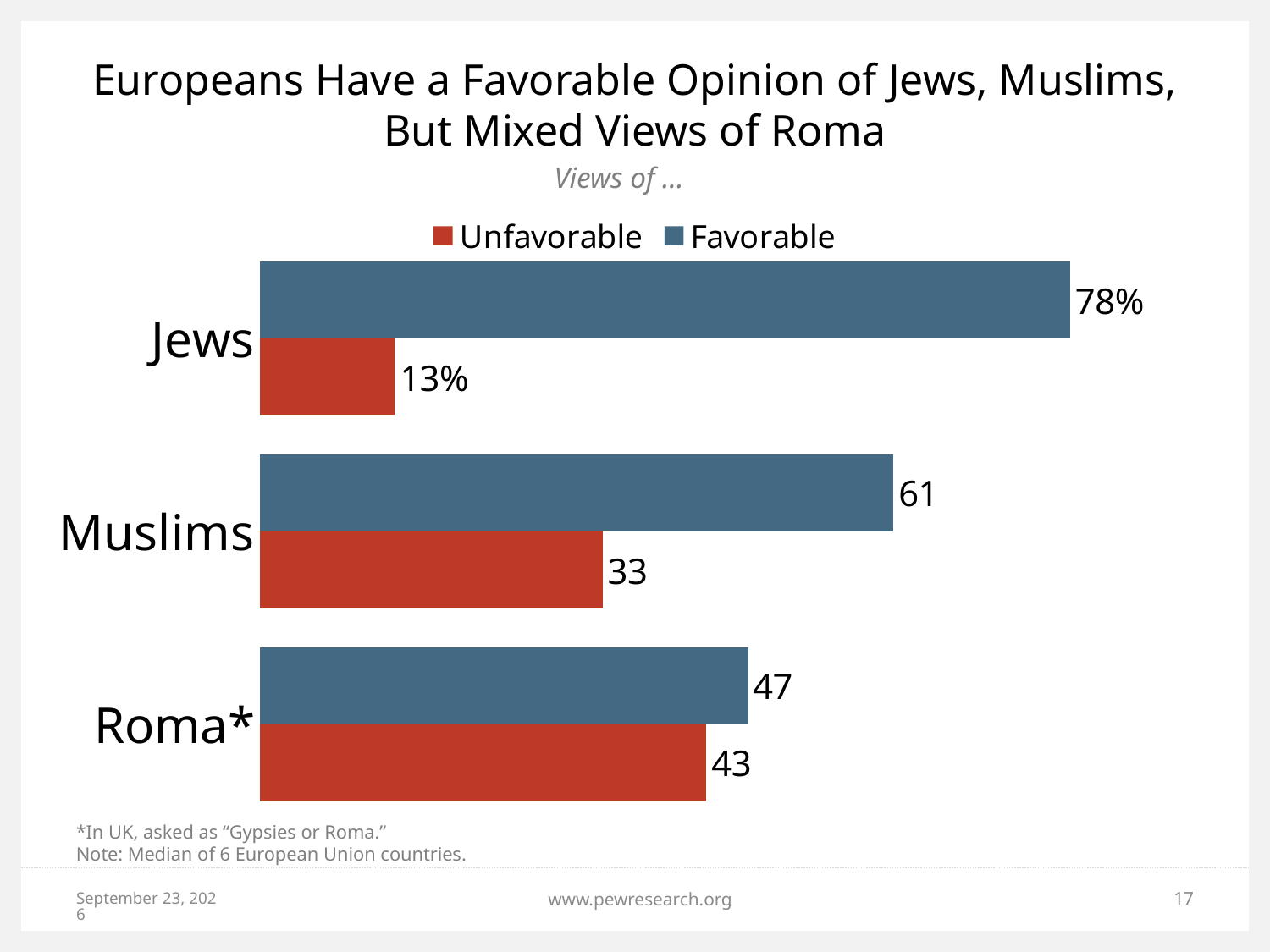
What is the Favorable value for Jews? 78% What is the Favorable value for Roma*? 47 What kind of chart is shown on the slide? Bar chart What is the Unfavorable value for Jews? 13% What is the difference between the Favorable and Unfavorable values for Muslims? 28 What is the Unfavorable value for Muslims? 33 How many series does the legend list? 2 Which is larger for Roma*, the Favorable or the Unfavorable value? Favorable How many groups are shown on the chart? 3 Which group has the lowest Unfavorable value? Jews Which group has the highest Favorable value? Jews Which colour represents the Unfavorable series in the legend? Red